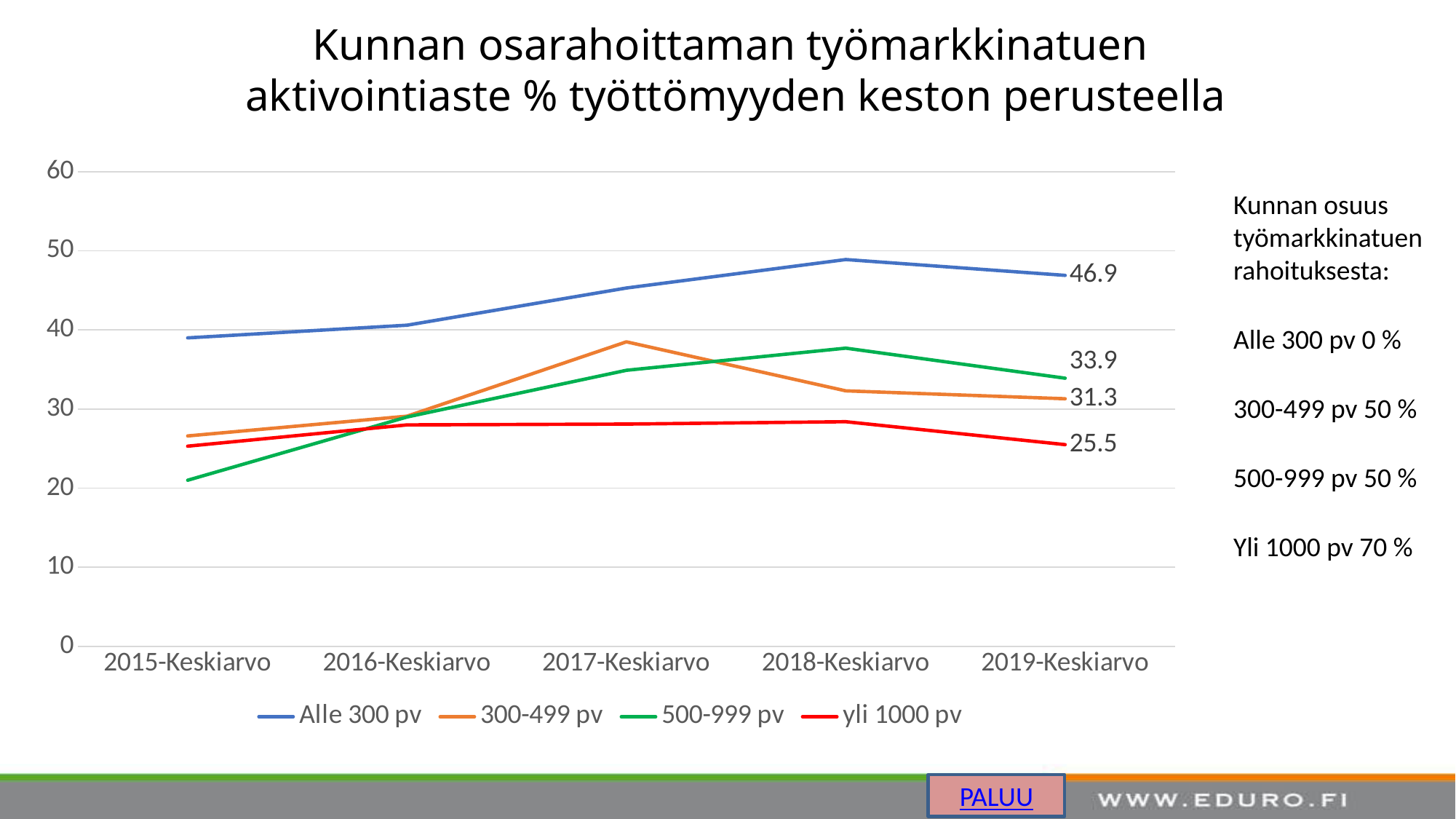
Does the Alle 300 pv line rise or fall from 2015-Keskiarvo to 2018-Keskiarvo? rise What type of chart is shown on the slide? line chart What is the value for Alle 300 pv at 2019-Keskiarvo? 46.9 How many points are plotted along the x axis for each series? 5 What is the difference between the Alle 300 pv and 500-999 pv values at 2019-Keskiarvo? 13.0 How many series does the legend list? 4 Is the value for Alle 300 pv at 2015-Keskiarvo greater or less than 40? less What is the value for 500-999 pv at 2019-Keskiarvo? 33.9 What is the value for yli 1000 pv at 2019-Keskiarvo? 25.5 What is the value for 300-499 pv at 2019-Keskiarvo? 31.3 Which series has the lowest value at 2019-Keskiarvo? yli 1000 pv Which series has the highest value at 2019-Keskiarvo? Alle 300 pv